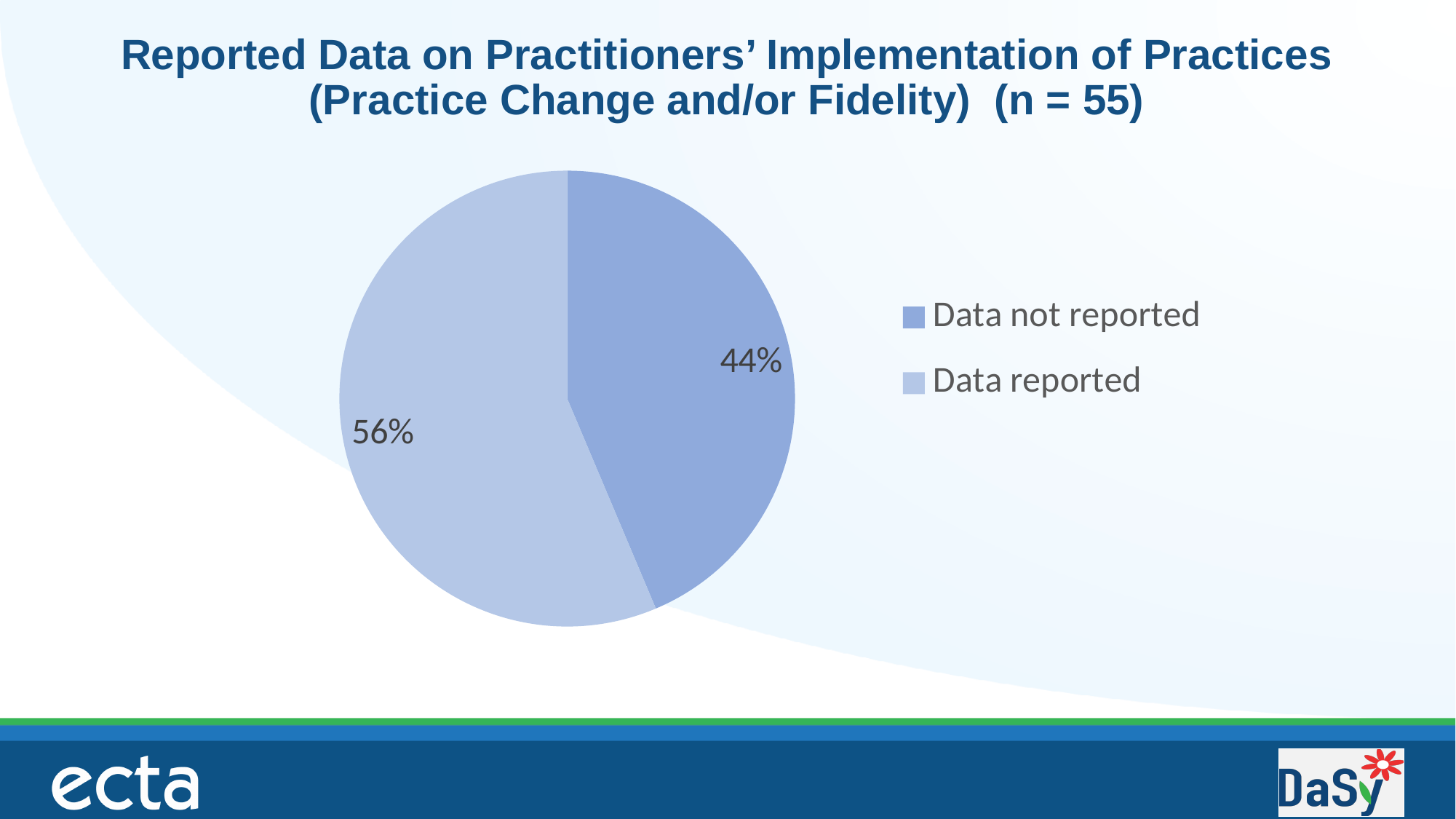
What kind of chart is shown on the slide? pie chart Which slice is the largest? Data reported What share of the pie is labelled "Data reported"? 56% What is the difference in percentage points between the "Data reported" and "Data not reported" slices? 12 How many entries does the legend list? 2 Which legend entry is shown in the darker blue colour? Data not reported How many slices does the pie chart have? 2 What is the sample size (n) given in the chart title? 55 Which is larger, the "Data reported" slice or the "Data not reported" slice? Data reported Which slice is the smallest? Data not reported Is the share for "Data not reported" greater or less than 50%? less What share of the pie is labelled "Data not reported"? 44%